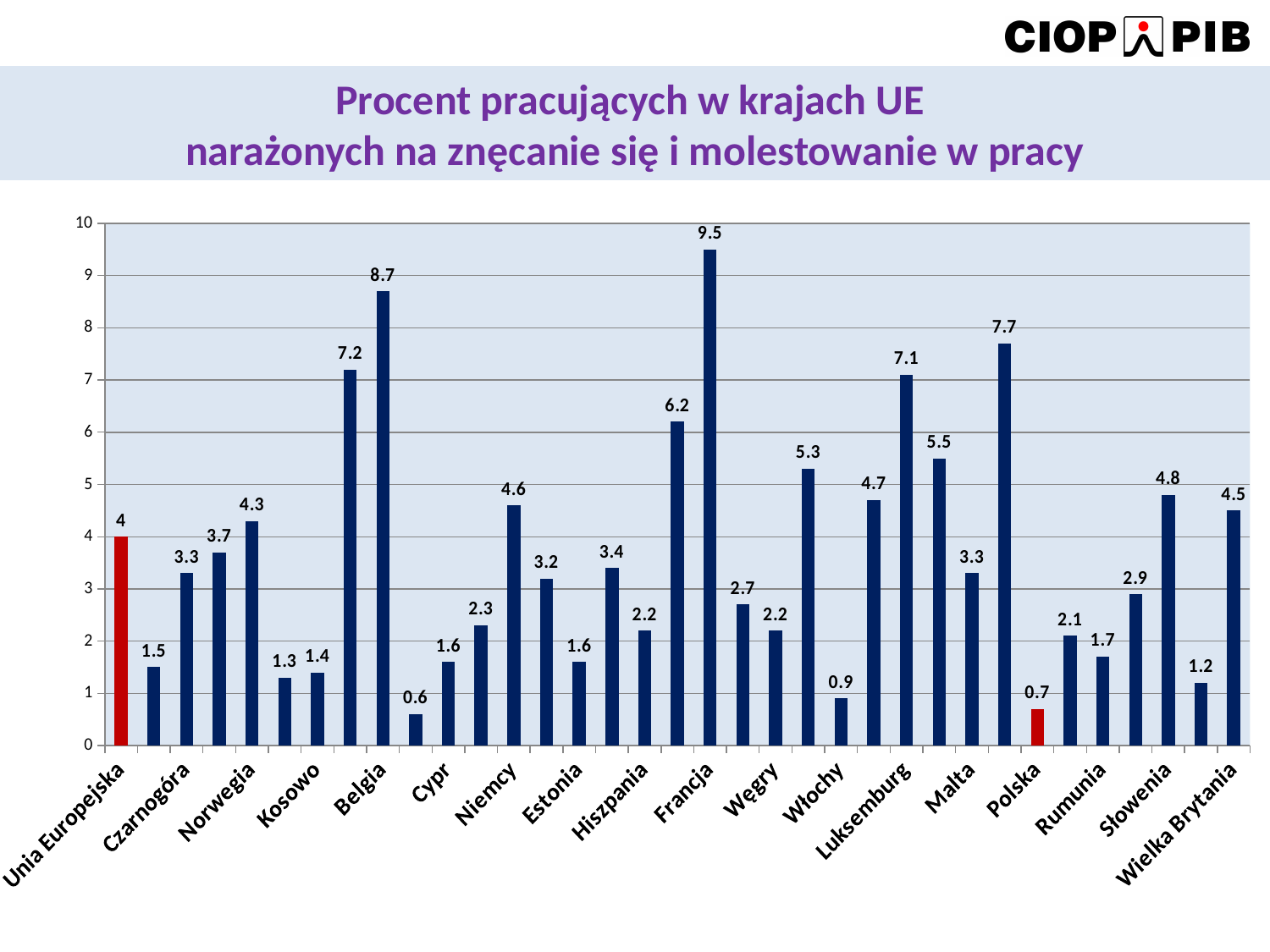
Is the value for Polska greater or less than 1? less What is the value for Belgia? 8.7 What is the difference between the values for Francja and Polska? 8.8 What is the value for Unia Europejska? 4 What is the value for Francja? 9.5 What is the value for Luksemburg? 7.1 Which is larger, the value for Belgia or the value for Luksemburg? Belgia What is the difference between the values for Belgia and Unia Europejska? 4.7 What kind of chart is shown on the slide? bar chart What is the value for Polska? 0.7 Which labelled country has the highest value? Francja Which two bars are coloured red? Unia Europejska and Polska